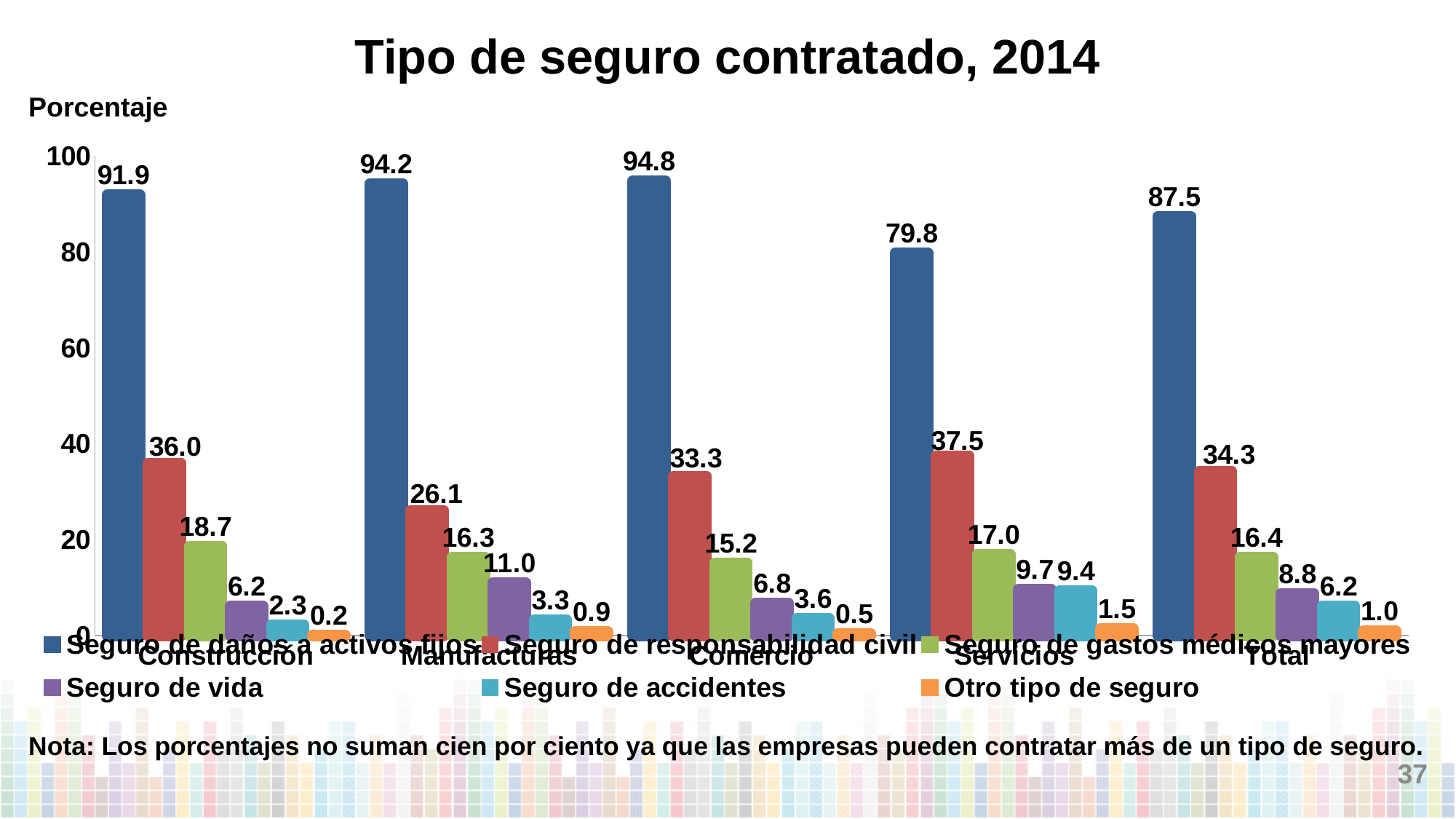
Which sector has the lowest value for Seguro de daños a activos fijos? Servicios Is the value of Seguro de daños a activos fijos for Total greater or less than 80? greater How many series does the legend list? 6 What is the value of Seguro de vida for Manufacturas? 11.0 Which sector has the highest value for Seguro de daños a activos fijos? Comercio How many sector categories are shown on the x axis? 5 What is the value of Seguro de daños a activos fijos for Comercio? 94.8 Which is larger: Seguro de accidentes for Servicios or for Total? Servicios What is the value of Seguro de responsabilidad civil for Construcción? 36.0 What is the difference between Seguro de daños a activos fijos for Manufacturas and for Servicios? 14.4 What kind of chart is shown on the slide? Bar chart What is the value of Otro tipo de seguro for Total? 1.0